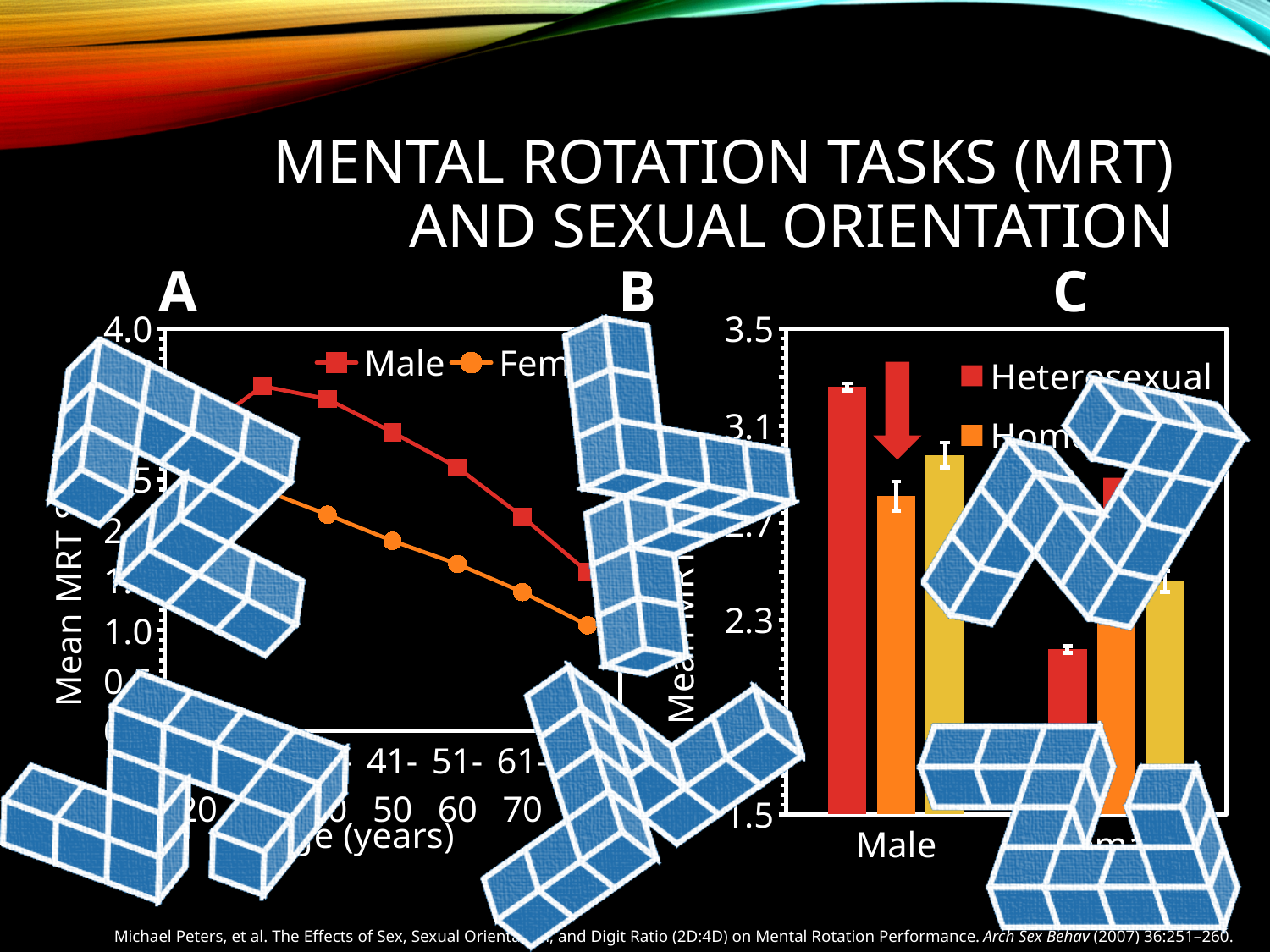
What kind of chart is chart A? line chart In chart C, is the Heterosexual value in the right-hand category greater or less than 2.3? less In chart A, which series has the higher values, Male or Female? Male In chart C, is the Heterosexual bar larger for the Male category or for the right-hand category? Male In chart A, is the rightmost Female value greater or less than 1.5? less In chart A, do the Male values rise or fall along the x axis? fall What kind of chart is chart C? bar chart In chart A, do the Female values rise or fall along the x axis? fall In chart C, which bar is highest in the Male category? Heterosexual In chart C, is the Heterosexual value for Male greater or less than 3.1? greater In chart A, what colour is the Male series? red